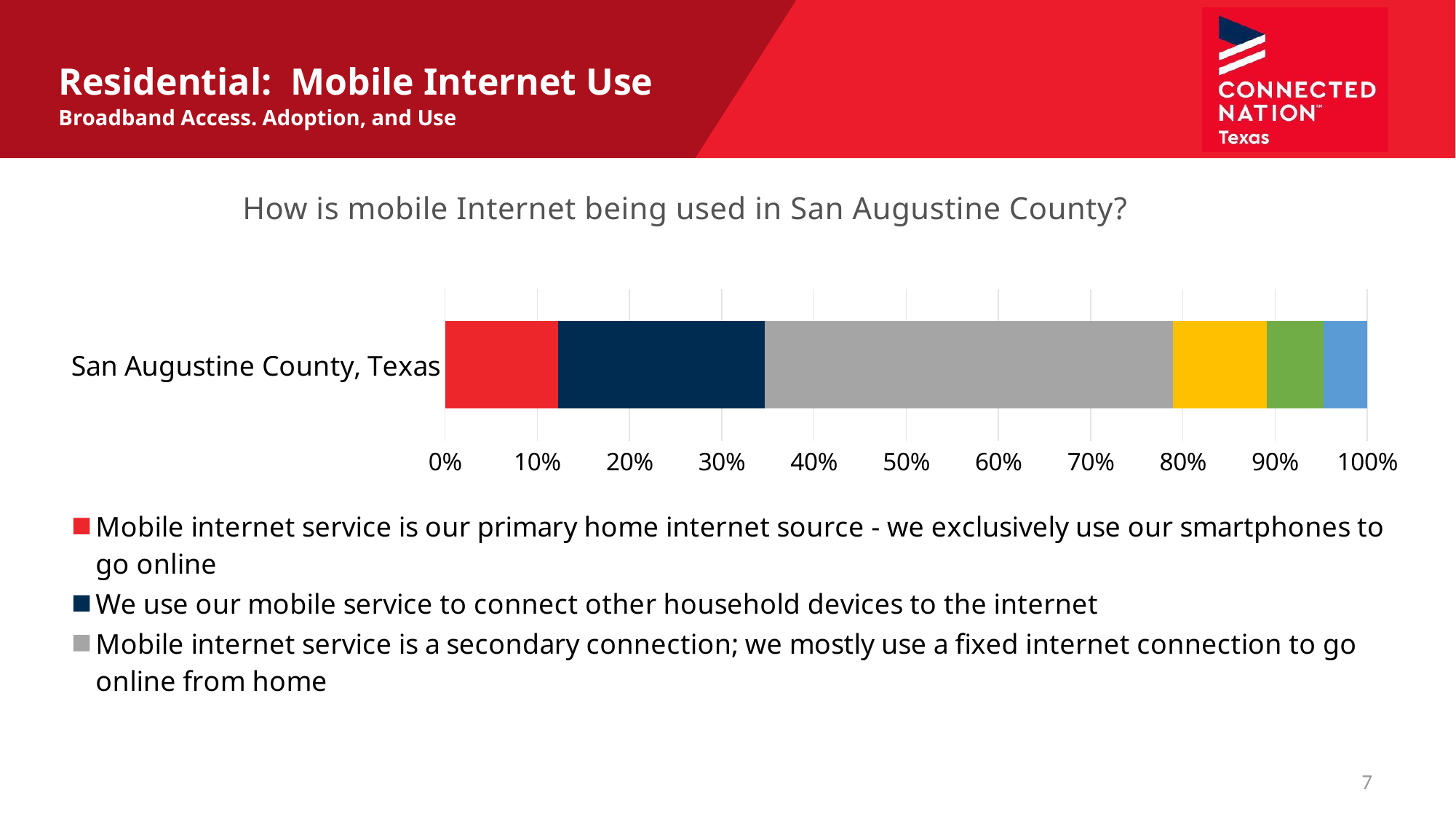
Which legend series occupies the largest share of the San Augustine County bar? Mobile internet service is a secondary connection; we mostly use a fixed internet connection to go online from home Which is larger: the segment for 'We use our mobile service to connect other household devices to the internet' or the segment for 'Mobile internet service is our primary home internet source - we exclusively use our smartphones to go online'? We use our mobile service to connect other household devices to the internet Is the value for 'Mobile internet service is our primary home internet source - we exclusively use our smartphones to go online' greater or less than 20%? less Is the value for 'Mobile internet service is a secondary connection; we mostly use a fixed internet connection to go online from home' greater or less than 40%? greater How many categories are plotted on the chart's vertical axis? 1 What is the single category shown on the chart? San Augustine County, Texas What is the total of the stacked bar for San Augustine County, Texas, as read from the axis? 100% What kind of chart is shown on the slide? Stacked bar chart What colour represents 'Mobile internet service is a secondary connection; we mostly use a fixed internet connection to go online from home' in the legend? Gray Which of the three legend series occupies the smallest share of the San Augustine County bar? Mobile internet service is our primary home internet source - we exclusively use our smartphones to go online Is the value for 'We use our mobile service to connect other household devices to the internet' greater or less than 30%? less How many series does the chart's legend list? 3